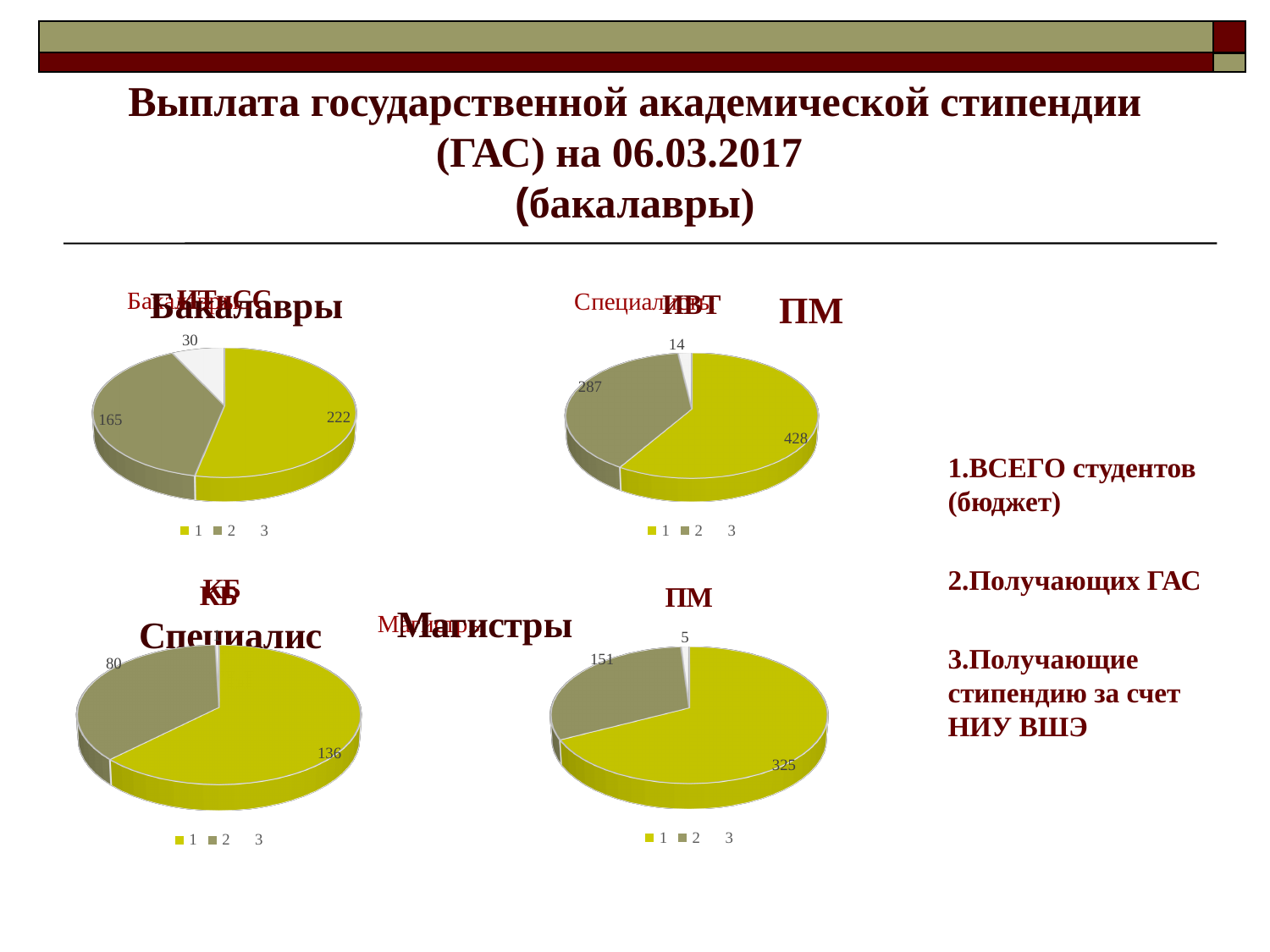
In the top-right pie chart, what is the difference between the values 428 and 287? 141 In the top-right pie chart, which category has the smallest value? 3 What type of chart is the top-left chart on the slide? pie chart In the bottom-right pie chart, what is the difference between the values for category 1 and category 2? 174 In the bottom-right pie chart, what is the value of category 2? 151 How many entries does the legend of the bottom-right pie chart list? 3 In the bottom-left pie chart, which is larger: the value for category 1 or category 2? category 1 In the bottom-left pie chart, what is the value of category 1? 136 In the top-right pie chart, which category has the largest value? 1 In the top-left pie chart, what is the value of the smallest slice (category 3)? 30 In the top-left pie chart, what is the value of the largest slice (category 1)? 222 In the top-right pie chart, what is the value of category 2? 287